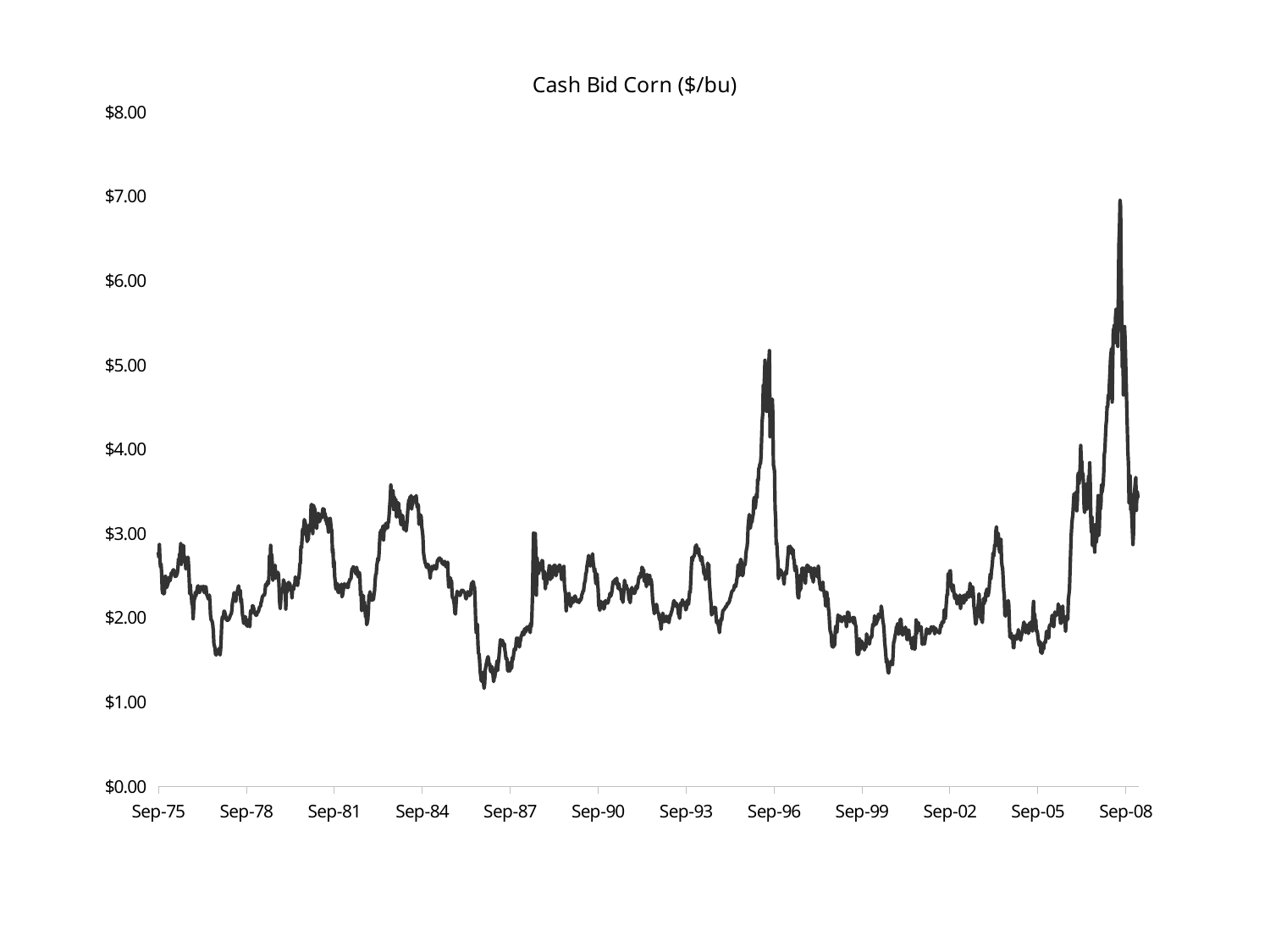
Is the lowest value reached between Sep-84 and Sep-87 greater or less than $2.00? less Is the peak value reached around Sep-96 greater or less than $4.00? greater Is the value at Sep-99 greater or less than $3.00? less What is the title of the chart? Cash Bid Corn ($/bu) Which peak is higher, the one around Sep-96 or the one near Sep-08? the one near Sep-08 What is the highest value shown on the vertical axis? $8.00 Does the line generally rise or fall between Sep-05 and Sep-08? rise Around which horizontal-axis label does the line reach its highest point? Sep-08 What kind of chart is shown on the slide? line chart How many labelled tick marks are on the horizontal axis? 12